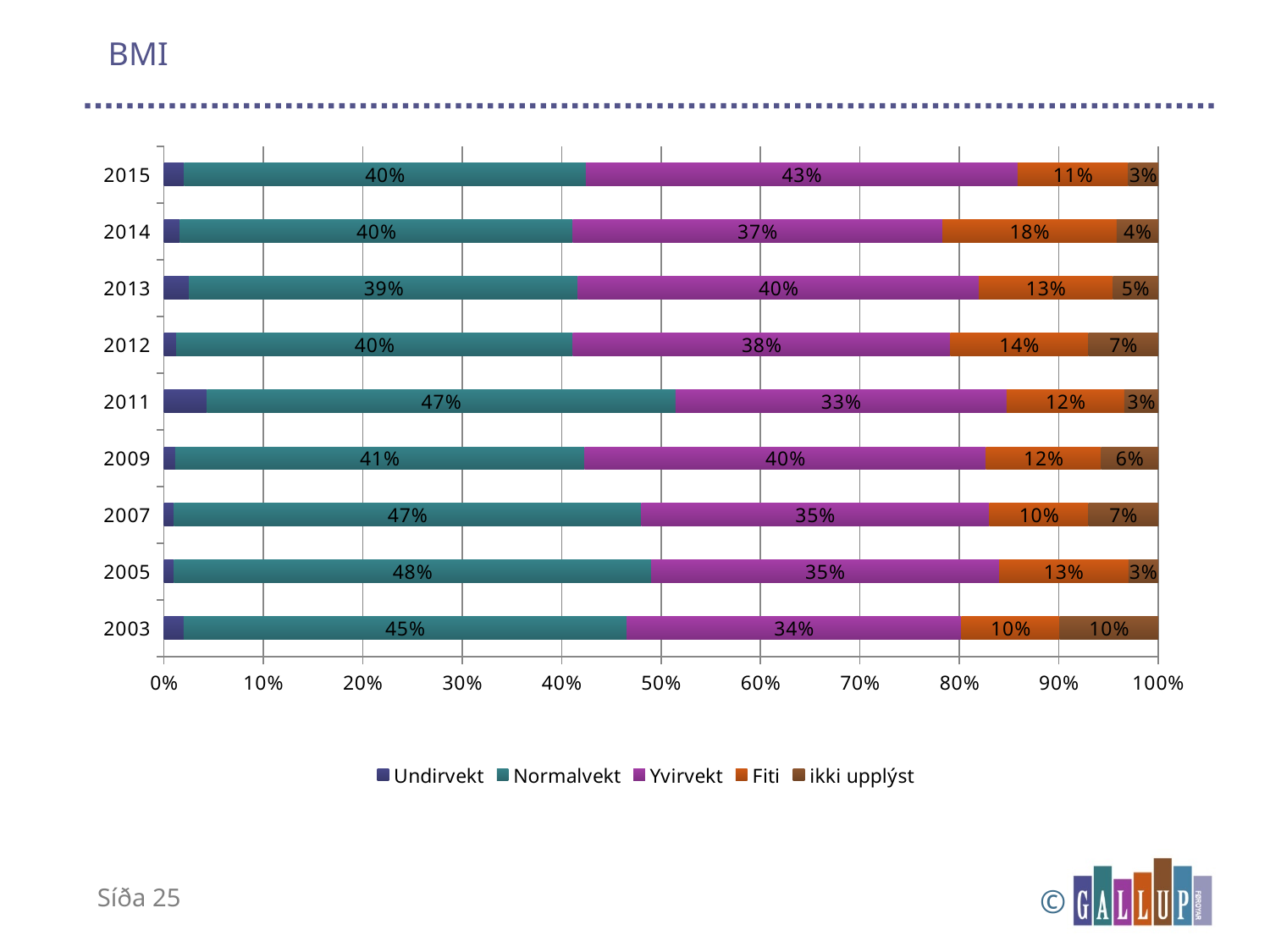
What kind of chart is shown on the slide? Stacked bar chart In which year is the Fiti value highest? 2014 What is the Normalvekt value for 2011? 47% What is the ikki upplýst value for 2003? 10% Is the Undirvekt value for 2011 greater or less than 10%? less In which year is the Yvirvekt value lowest? 2011 By how many percentage points does the Yvirvekt value for 2015 exceed the Yvirvekt value for 2014? 6 How many series does the legend list? 5 What is the Yvirvekt value for 2015? 43% What is the Fiti value for 2014? 18% For 2003, which is larger: the Normalvekt value or the Yvirvekt value? Normalvekt How many years are shown on the chart? 9